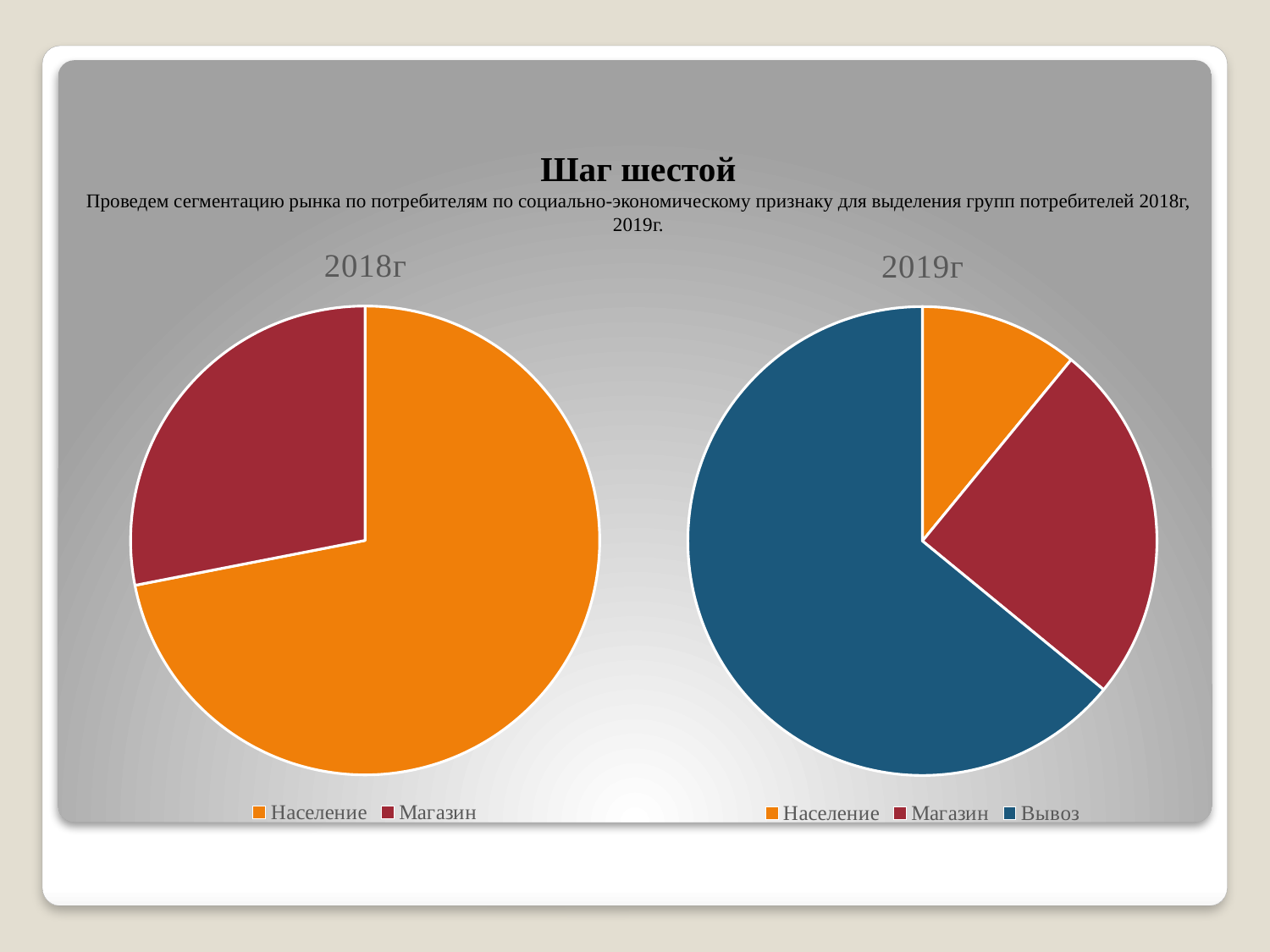
In the chart titled 2018г, which category has the largest slice? Население In the chart titled 2018г, how many slices does the pie have? 2 In the chart titled 2019г, which legend entry appears in the 2019г chart but not in the 2018г chart? Вывоз What kind of chart is the chart titled 2019г? pie chart In the chart titled 2019г, which category has the largest slice? Вывоз In the chart titled 2018г, how many entries does the legend list? 2 In the chart titled 2019г, which category has the smallest slice? Население In the chart titled 2019г, how many entries does the legend list? 3 In the chart titled 2019г, which slice is larger, Магазин or Население? Магазин What kind of chart is the chart titled 2018г? pie chart In the chart titled 2019г, how many slices does the pie have? 3 In the chart titled 2018г, which category has the smallest slice? Магазин